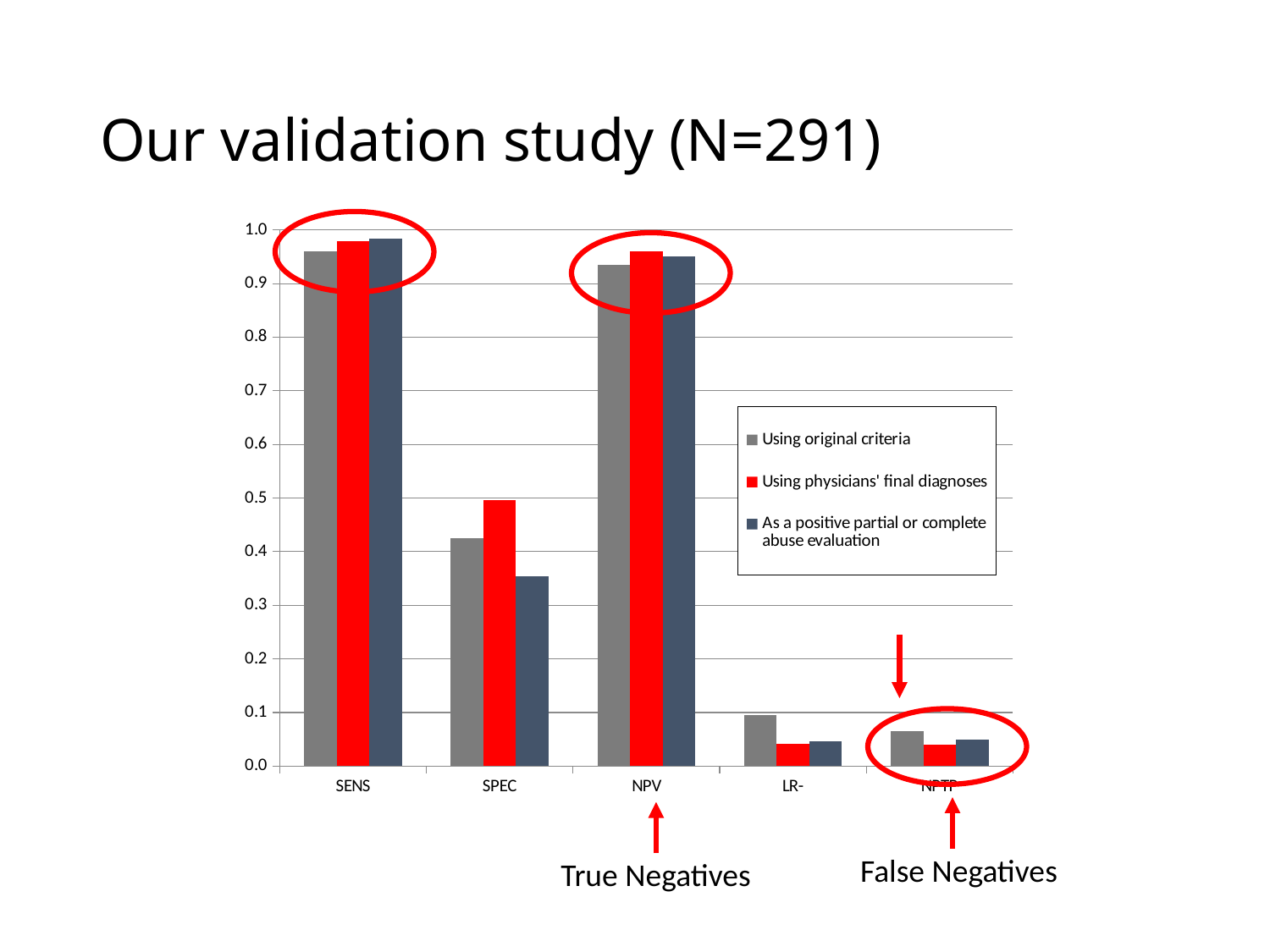
Is the value for SENS under 'Using original criteria' greater or less than 0.9? greater What colour represents 'Using physicians' final diagnoses' in the legend? Red For SPEC, which series has the lowest bar? As a positive partial or complete abuse evaluation For LR-, which is larger: 'Using original criteria' or 'Using physicians' final diagnoses'? Using original criteria Is the value for SPEC under 'Using original criteria' greater or less than 0.5? less How many categories are shown on the x axis? 5 How many series does the legend list? 3 Under 'Using original criteria', which is larger: SENS or SPEC? SENS What kind of chart is shown on the slide? Bar chart Is the value for NPV under 'Using original criteria' greater or less than 0.9? greater For SPEC, which series has the highest bar? Using physicians' final diagnoses